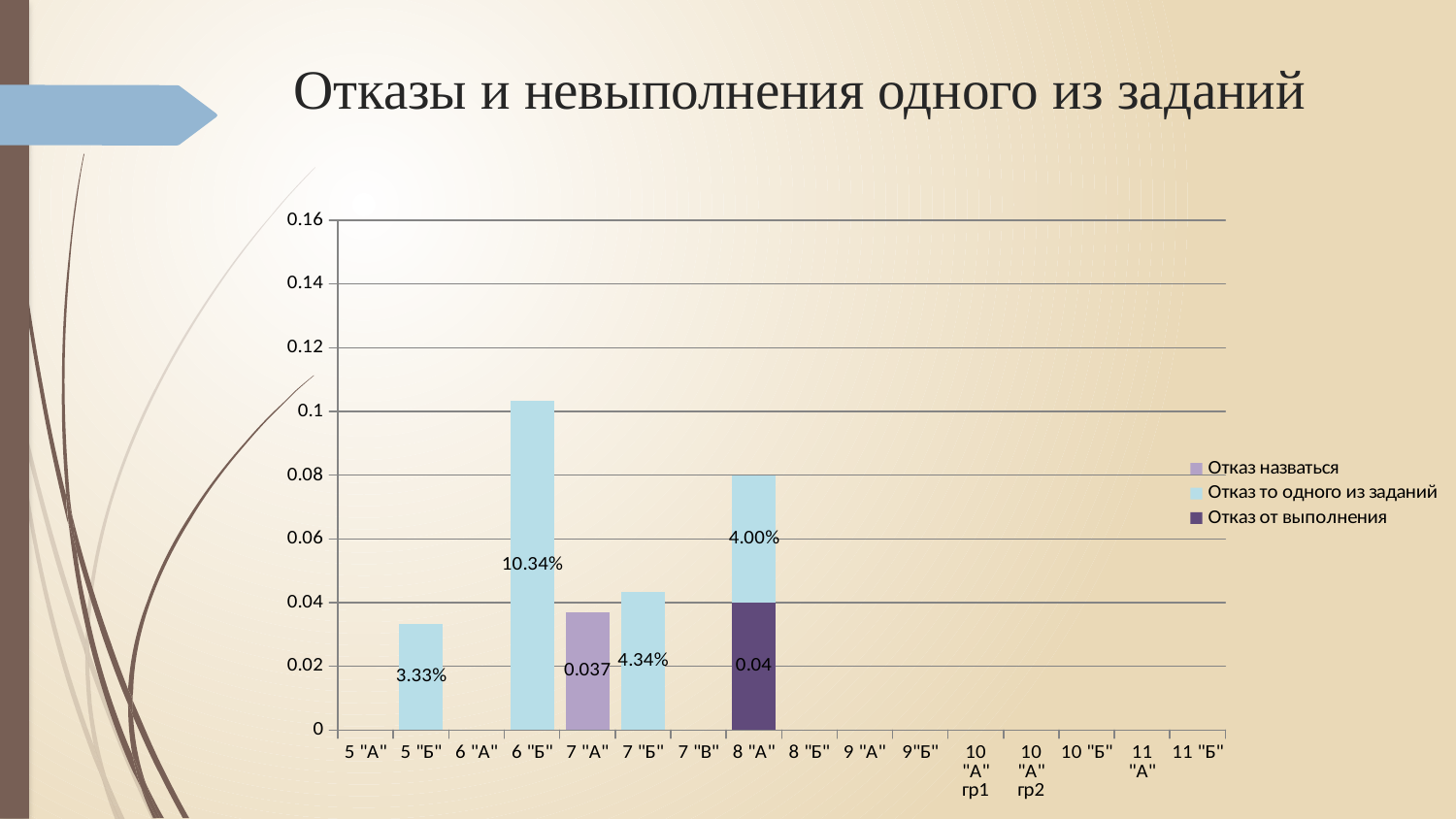
What is the data label on the bar for 5 "Б"? 3.33% What colour represents "Отказ от выполнения" in the legend? dark purple What is the data label on the "Отказ то одного из заданий" segment for 8 "А"? 4.00% What kind of chart is shown on the slide? bar chart How many categories are shown on the x axis? 16 What is the value of "Отказ от выполнения" for 8 "А"? 0.04 Which category has the tallest bar? 6 "Б" Which is larger, the "Отказ то одного из заданий" value for 6 "Б" or for 7 "Б"? 6 "Б" How many series does the legend list? 3 Is the bar for 6 "Б" greater or less than 0.1? greater What is the data label on the bar for 6 "Б"? 10.34% What is the value of "Отказ назваться" for 7 "А"? 0.037